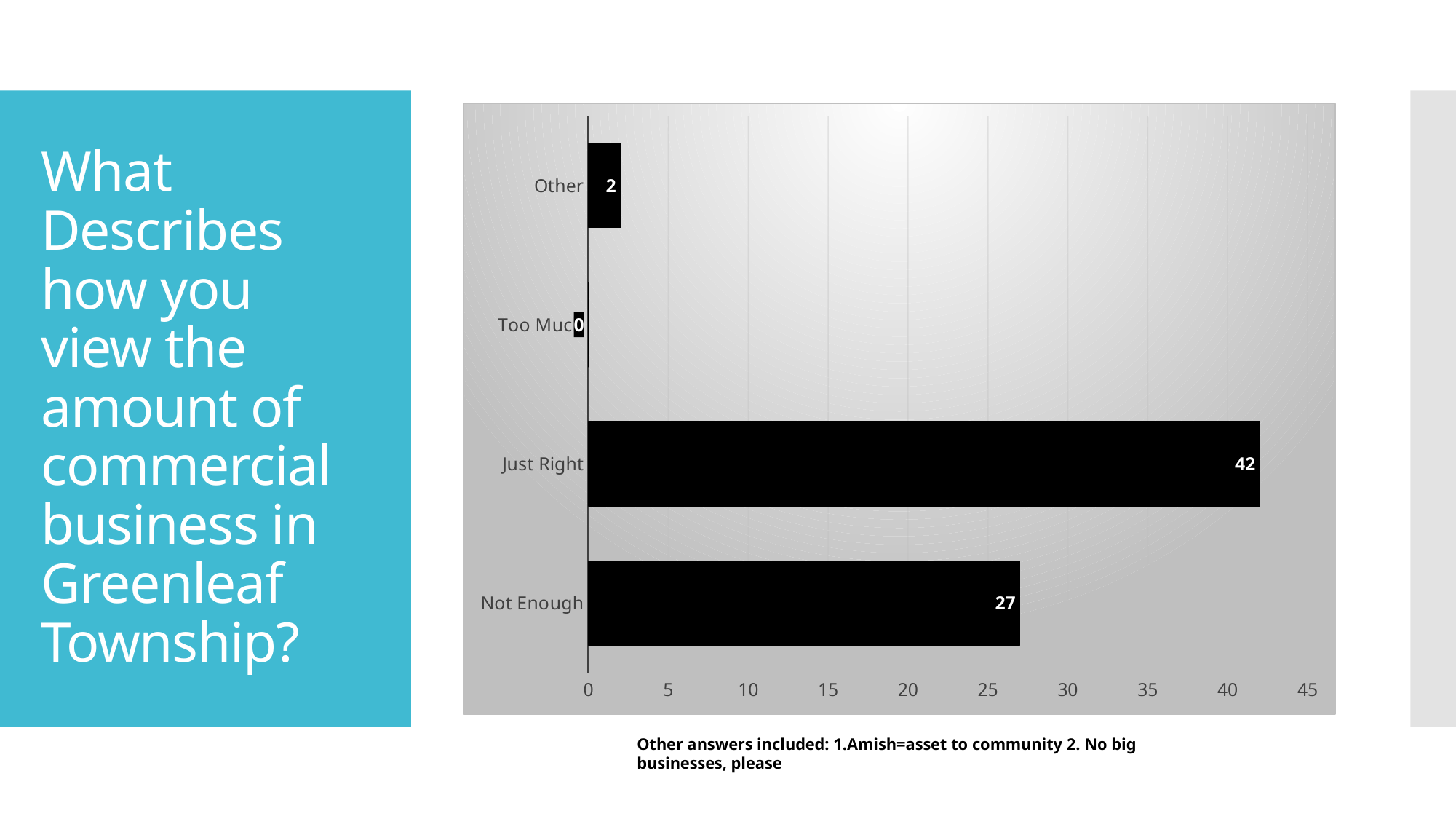
Which category has the highest value? Just Right What is the value for Not Enough? 27 Is the value for Just Right greater or less than 40? greater What is the highest value shown on the horizontal axis? 45 What is the value for Too Much? 0 How many categories are shown in the chart? 4 What is the difference between the values for Just Right and Not Enough? 15 What kind of chart is shown on the slide? bar chart Which category has the lowest value? Too Much What is the value for Other? 2 What is the value for Just Right? 42 Which is larger, the value for Not Enough or the value for Other? Not Enough